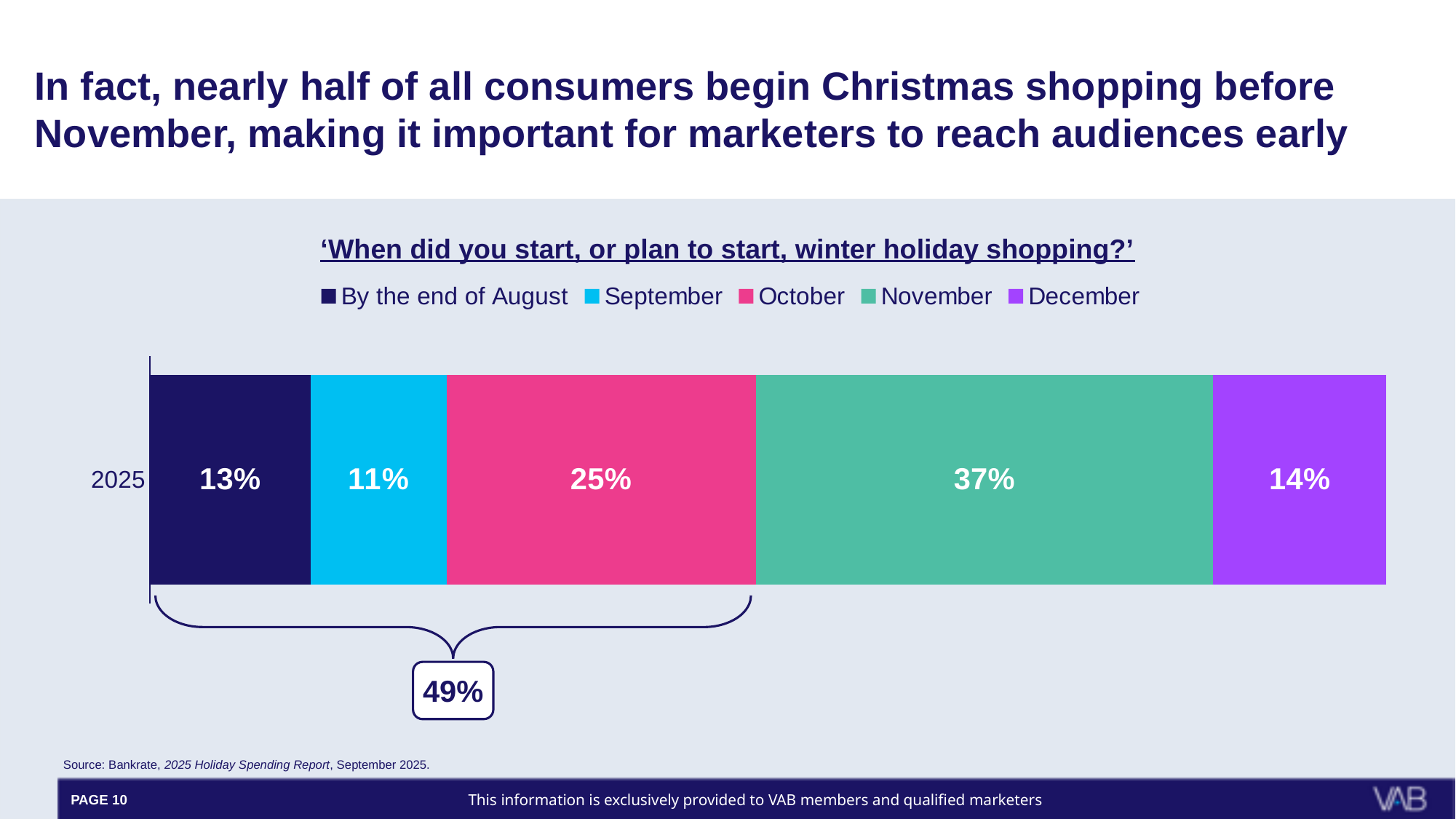
What percentage of consumers started winter holiday shopping by the end of August? 13% What percentage of consumers started winter holiday shopping in December? 14% What is the combined share of consumers who started shopping by the end of August, in September, or in October? 49% What kind of chart is shown on the slide? Stacked bar chart How many series does the legend list? 5 What percentage of consumers started winter holiday shopping in October? 25% What is the total of all segments in the 2025 bar? 100% Which is larger, the share for December or the share for By the end of August? December What is the difference between the November share and the October share? 12% What is the title of the chart? 'When did you start, or plan to start, winter holiday shopping?' Which start period has the largest share of consumers? November Which start period has the smallest share of consumers? September